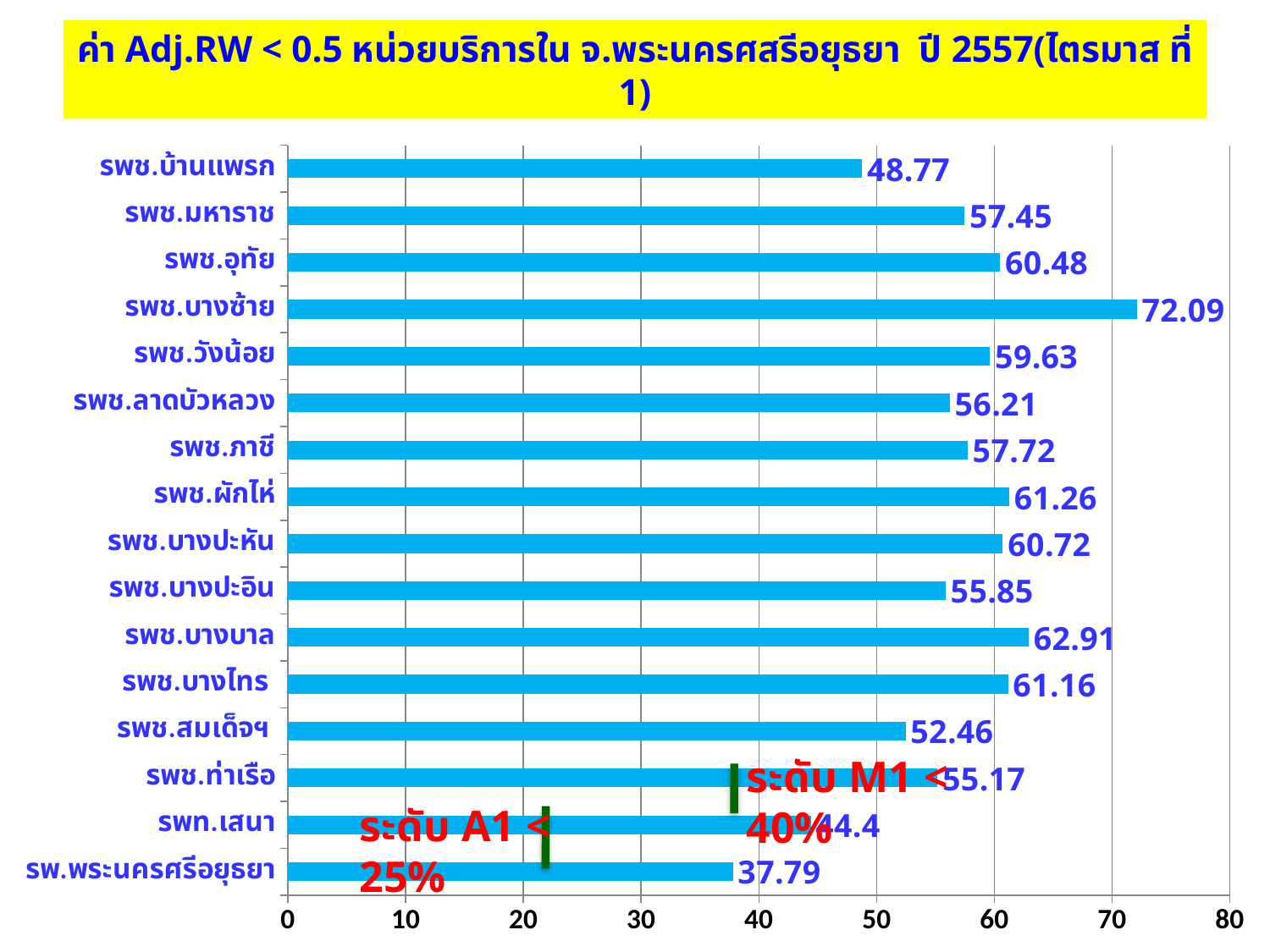
What is the value for รพช.บ้านแพรก? 48.77 Which category has the highest value? รพช.บางซ้าย Which has a larger value, รพช.บ้านแพรก or รพช.มหาราช? รพช.มหาราช How many categories are shown in the chart? 16 What is the difference between the values for รพช.บางซ้าย and รพ.พระนครศรีอยุธยา? 34.30 What is the value for รพช.บางบาล? 62.91 What kind of chart is shown on the slide? bar chart Which category has the lowest value? รพ.พระนครศรีอยุธยา What is the value for รพท.เสนา? 44.4 What is the title of the chart? ค่า Adj.RW < 0.5 หน่วยบริการใน จ.พระนครศรีอยุธยา ปี 2557(ไตรมาส ที่ 1) What is the difference between the values for รพช.บางบาล and รพช.สมเด็จฯ? 10.45 Is the value for รพช.บางซ้าย greater or less than 70? greater